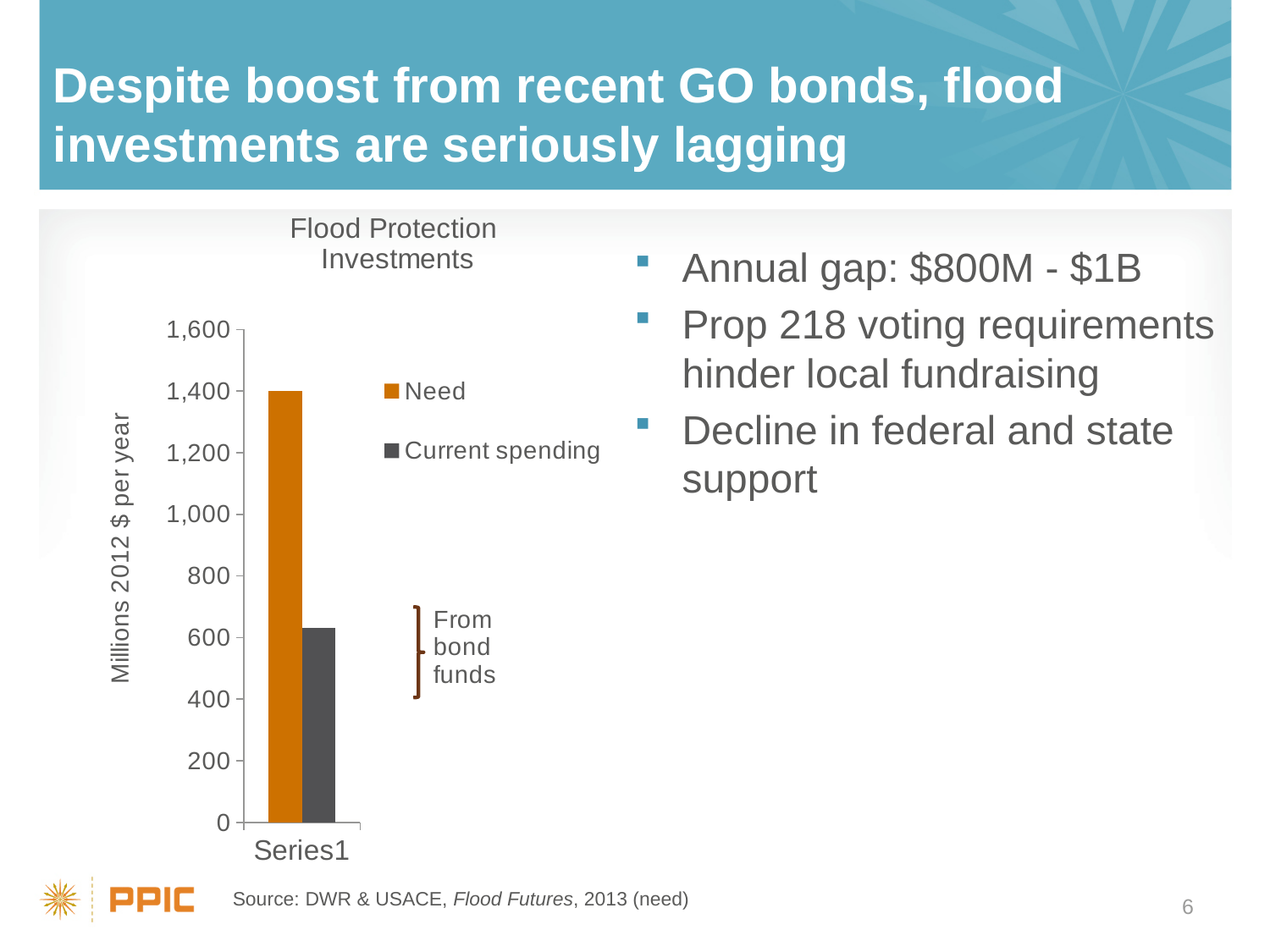
Which series has the tallest bar in the chart? Need How many series does the chart legend list? 2 Is the value for Need greater or less than 1,200? greater Is the value for Current spending greater or less than 800? less How many categories are shown on the x axis of the chart? 1 Is the value for Current spending greater or less than 400? greater What kind of chart is shown on the slide? bar chart Which series has the shortest bar in the chart? Current spending Which series has the higher bar, Need or Current spending? Need What is the value of the Need bar, in millions of 2012 dollars per year? 1,400 What is the title of the chart? Flood Protection Investments What are the two series named in the chart legend? Need and Current spending